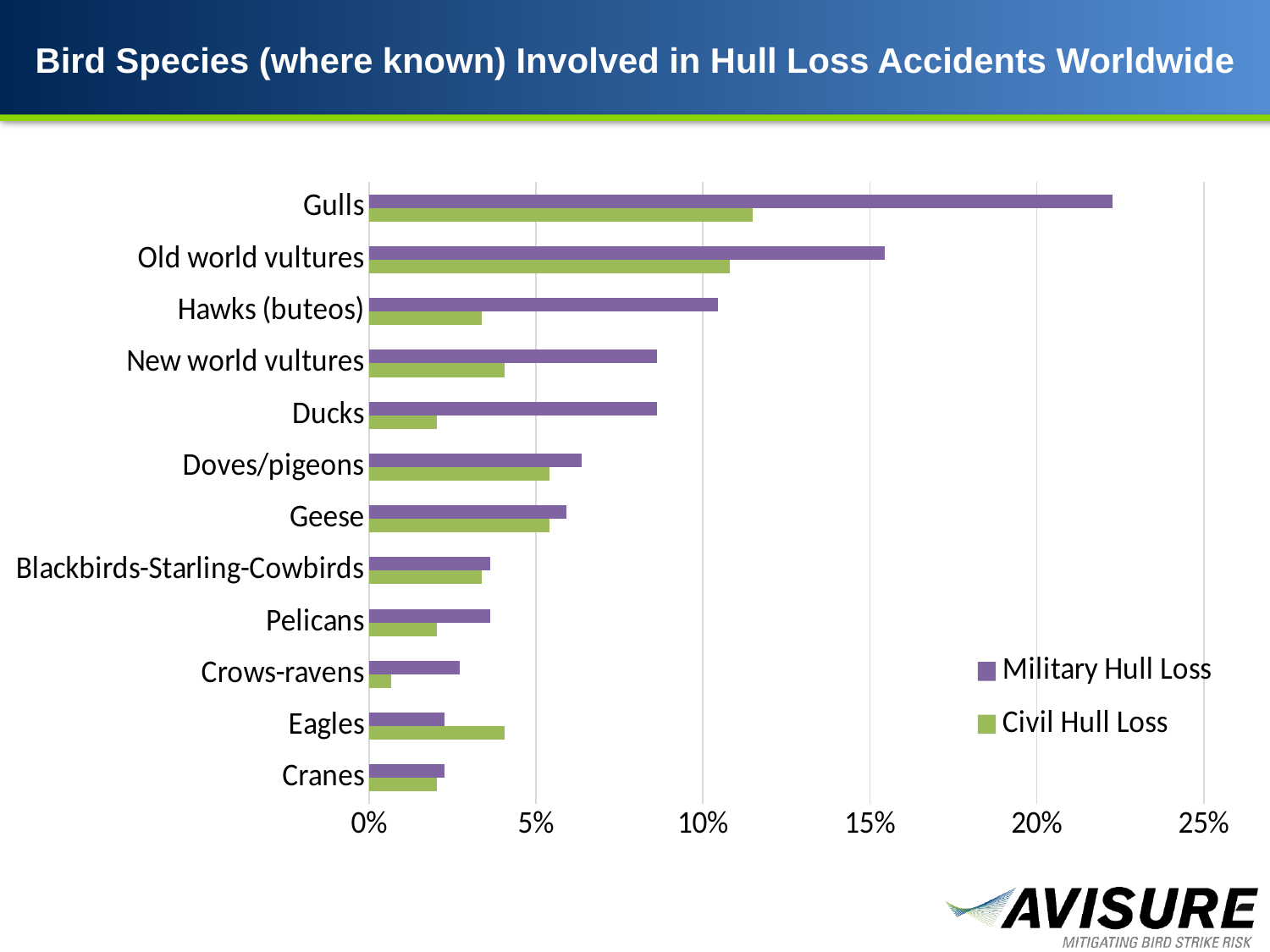
Is the Military Hull Loss value for Gulls greater or less than 20%? greater Which bird species has the highest Military Hull Loss value? Gulls Is the Military Hull Loss value for Hawks (buteos) greater or less than 10%? greater What kind of chart is shown on the slide? bar chart Is the Civil Hull Loss value for Hawks (buteos) greater or less than 5%? less Which bird species has the highest Civil Hull Loss value? Gulls How many series does the legend list? 2 For Eagles, which is larger: the Military Hull Loss value or the Civil Hull Loss value? Civil Hull Loss Which colour represents the Civil Hull Loss series in the legend? green How many bird species categories are plotted on the chart? 12 Which bird species has the lowest Civil Hull Loss value? Crows-ravens